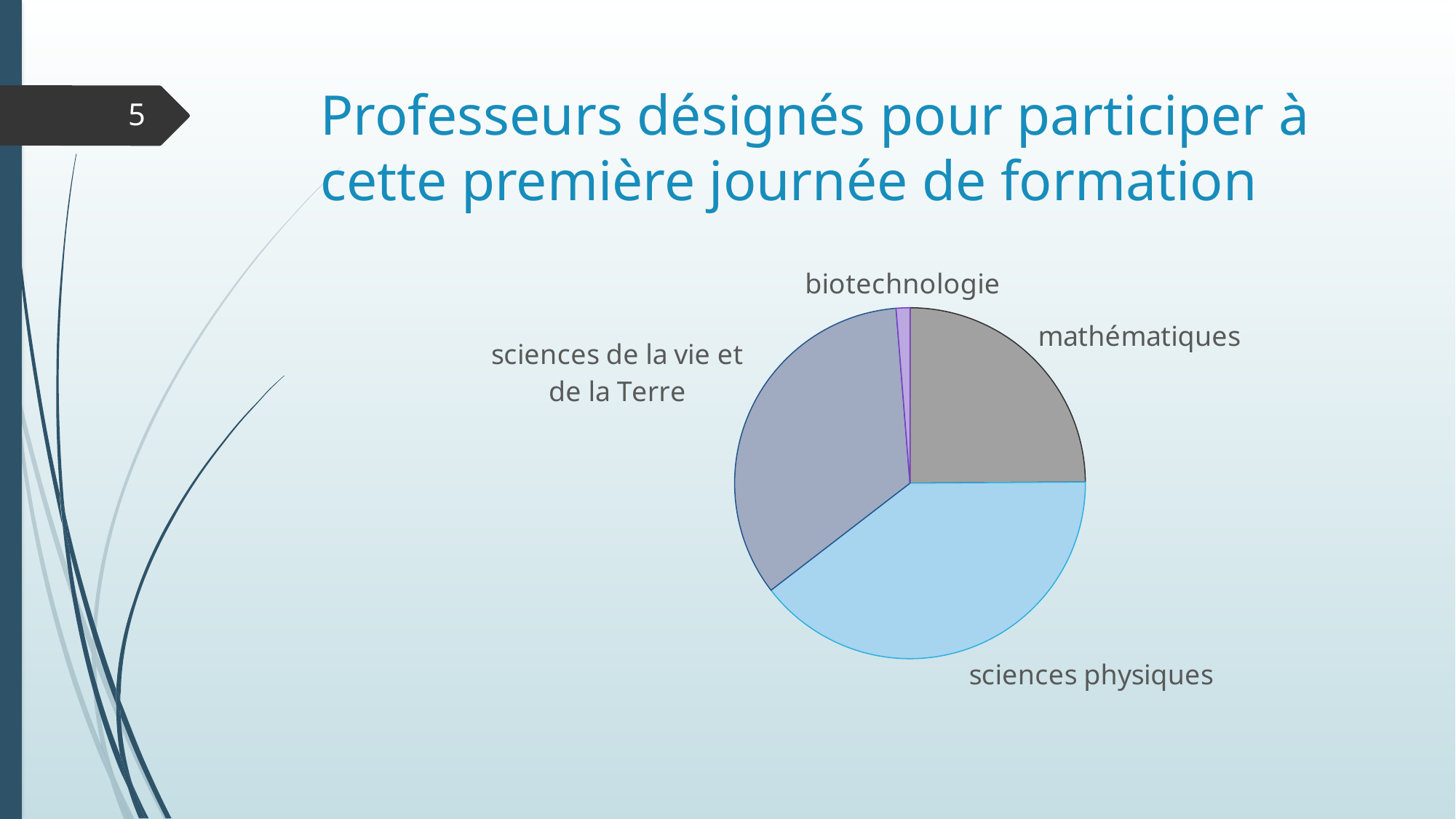
Which slice is larger, sciences de la vie et de la Terre or mathématiques? sciences de la vie et de la Terre What kind of chart is shown on the slide? pie chart Which slice is larger, mathématiques or biotechnologie? mathématiques What is the title of the slide containing the pie chart? Professeurs désignés pour participer à cette première journée de formation What colour is the sciences physiques slice of the pie chart? light blue Which category has the smallest slice of the pie chart? biotechnologie Which slice is larger, sciences de la vie et de la Terre or biotechnologie? sciences de la vie et de la Terre How many slices does the pie chart have? 4